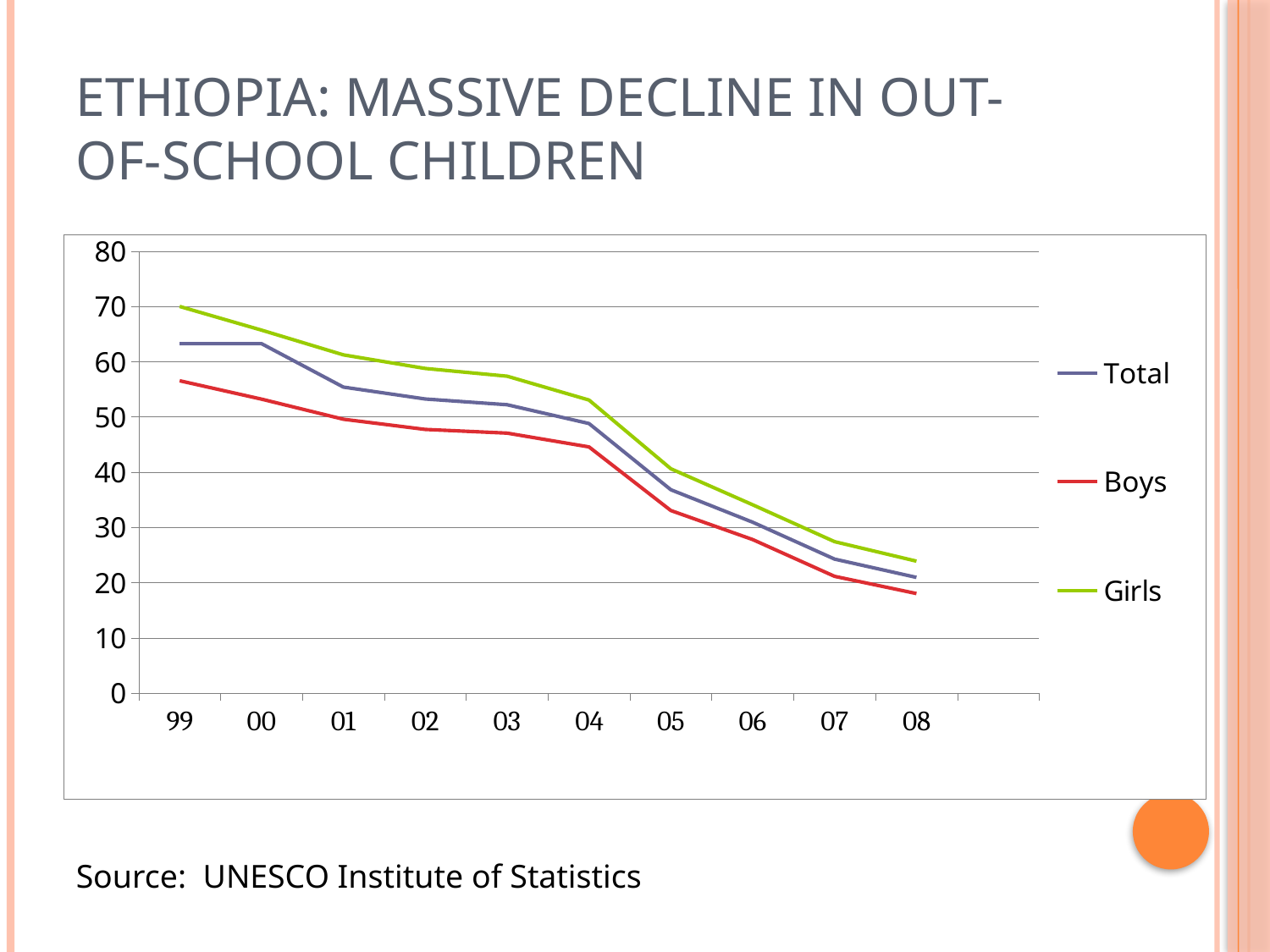
How many years are plotted along the x axis? 10 Do the values for Boys rise or fall from 99 to 08? fall What kind of chart is shown on the slide? line chart Is the value for Total in 08 greater or less than 30? less Is the value for Girls in 05 greater or less than 50? less Is the value for Boys in 99 greater or less than 50? greater Which series has the lowest value in 08: Total, Boys or Girls? Boys In 04, is the value for Girls or for Boys larger? Girls How many series does the legend list? 3 Do the values for Girls rise or fall from 99 to 08? fall Which series has the highest value in 99: Total, Boys or Girls? Girls What source is cited below the chart? UNESCO Institute of Statistics